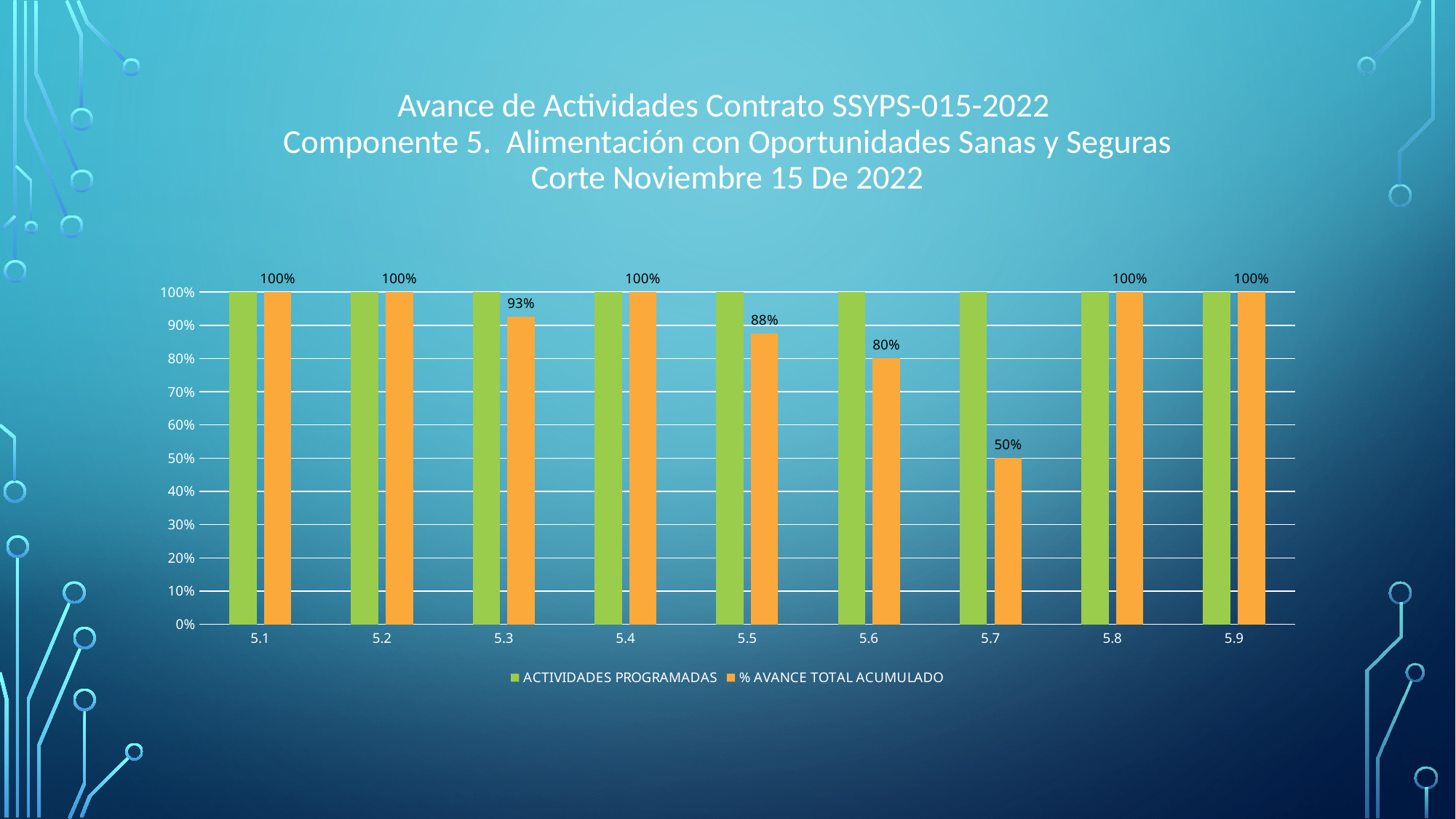
What kind of chart is shown on the slide? Bar chart How many series does the legend list? 2 What is the difference between the % AVANCE TOTAL ACUMULADO values for 5.5 and 5.7? 38% What is the % AVANCE TOTAL ACUMULADO value for category 5.6? 80% Which category has the lowest % AVANCE TOTAL ACUMULADO value? 5.7 What is the difference between the % AVANCE TOTAL ACUMULADO values for 5.3 and 5.6? 13% What is the % AVANCE TOTAL ACUMULADO value for category 5.7? 50% How many categories are shown on the x axis? 9 Which is larger, the % AVANCE TOTAL ACUMULADO value for 5.5 or for 5.6? 5.5 What is the % AVANCE TOTAL ACUMULADO value for category 5.5? 88% Is the ACTIVIDADES PROGRAMADAS value for 5.7 greater or less than 90%? greater What is the % AVANCE TOTAL ACUMULADO value for category 5.3? 93%